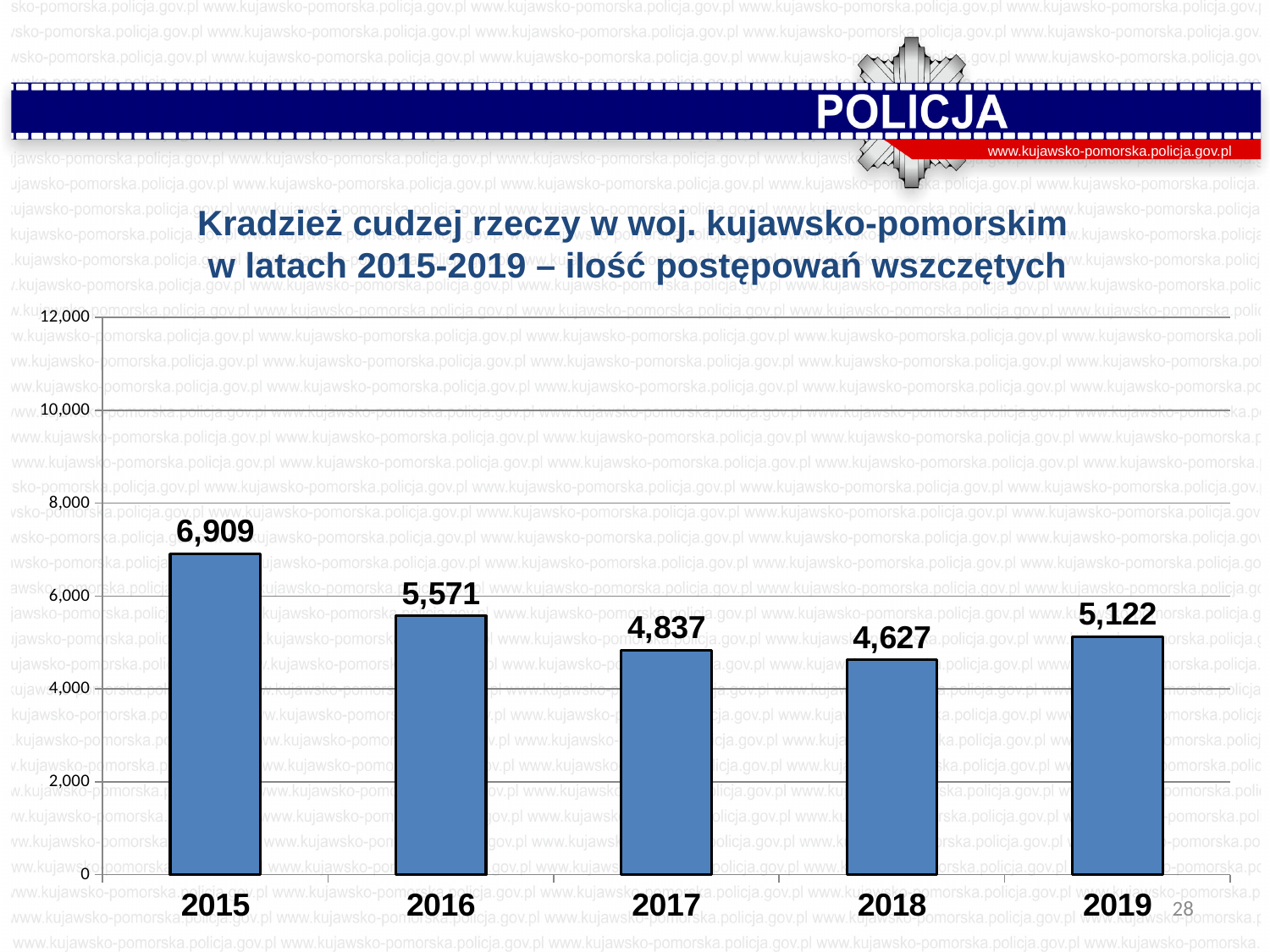
Is the value for 2017 greater or less than 6,000? less Which year has the lowest value? 2018 How many years are shown on the chart? 5 What is the value for 2015? 6,909 What is the difference between the values for 2015 and 2016? 1,338 What is the value for 2019? 5,122 What is the value for 2017? 4,837 Do the values rise or fall from 2015 to 2018? fall What is the difference between the values for 2019 and 2018? 495 Which is larger, the value for 2016 or the value for 2019? 2016 Which year has the highest value? 2015 What kind of chart is shown on the slide? bar chart